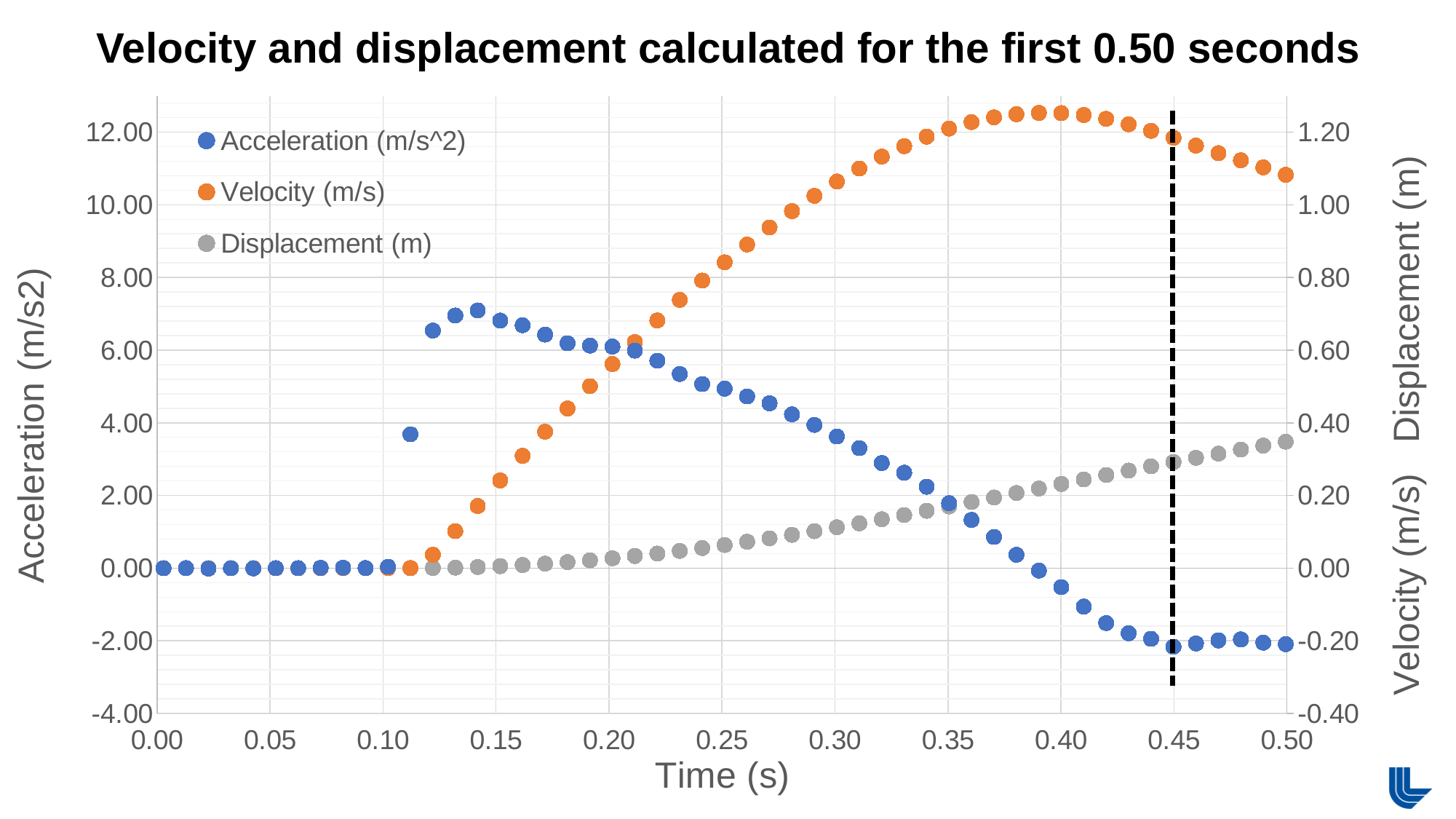
Is the Velocity value at 0.40 s greater or less than 1.00 m/s? greater Is the Acceleration value at 0.50 s greater or less than 0.00? less Is the Displacement value at 0.50 s greater or less than 0.20 m? greater How many series does the legend list? 3 Does the Displacement series rise or fall between 0.20 s and 0.50 s? rise Does the Velocity series rise or fall between 0.10 s and 0.35 s? rise What is the label of the x axis? Time (s) What is the title of the chart? Velocity and displacement calculated for the first 0.50 seconds What kind of chart is shown on the slide? scatter chart Does the Acceleration series rise or fall between 0.15 s and 0.45 s? fall